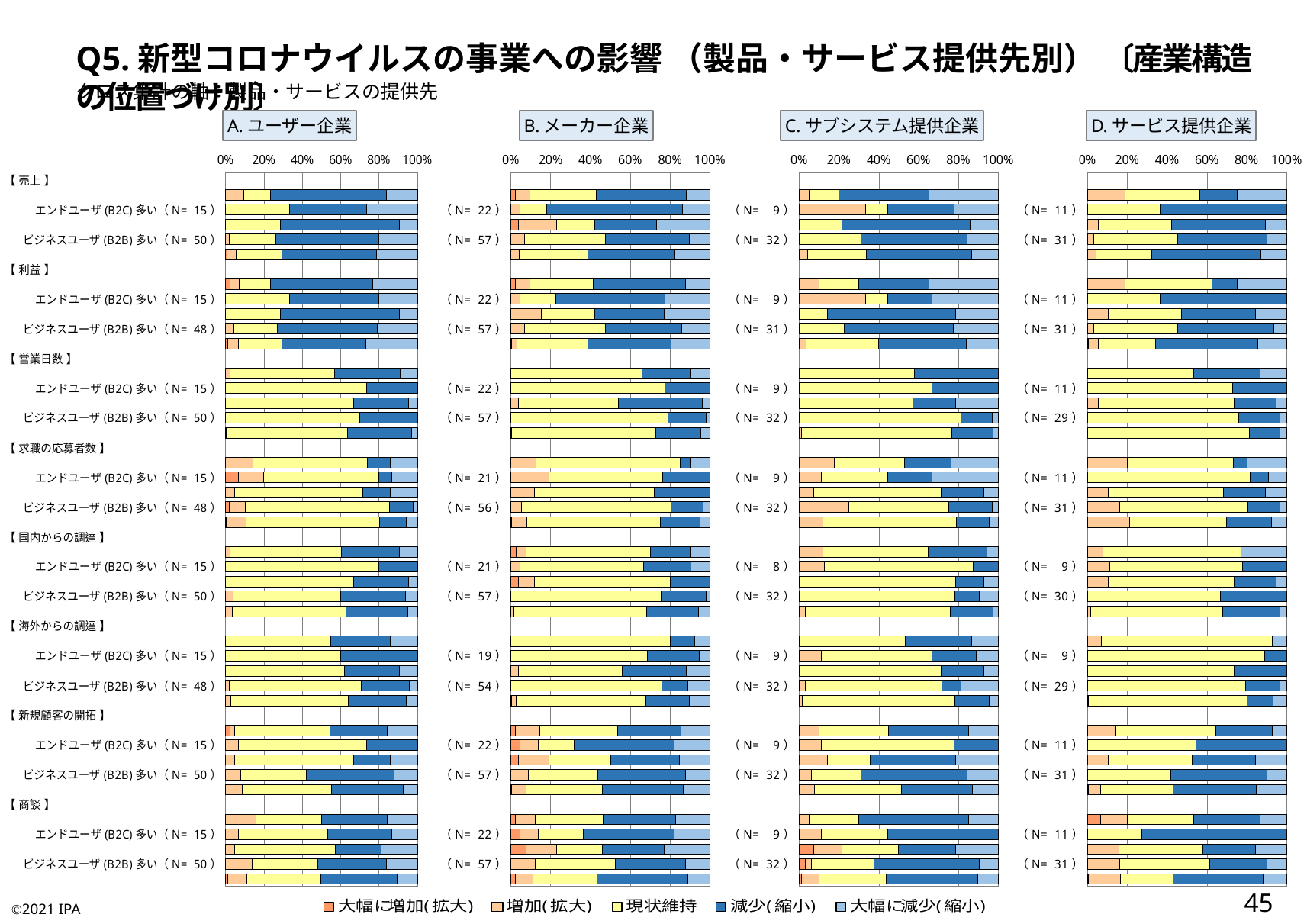
How many separate charts (panels) are shown on the slide? 4 In chart A (ユーザー企業), for 【営業日数】 in the エンドユーザ(B2C)多い row, is the 現状維持 share greater or less than 60%? greater What is the title of the leftmost chart panel? A. ユーザー企業 What is the title of the rightmost chart panel? D. サービス提供企業 In chart C (サブシステム提供企業), for 【国内からの調達】 in the ビジネスユーザ(B2B)多い row, is the 現状維持 share greater or less than 60%? greater In chart D (サービス提供企業), for 【営業日数】 in the ビジネスユーザ(B2B)多い row, is the 現状維持 share greater or less than 60%? greater What kind of chart is used in each of the four panels on this slide? Stacked bar chart What is the maximum value shown on the horizontal axis of each chart? 100% How many series does the legend at the bottom of the slide list? 5